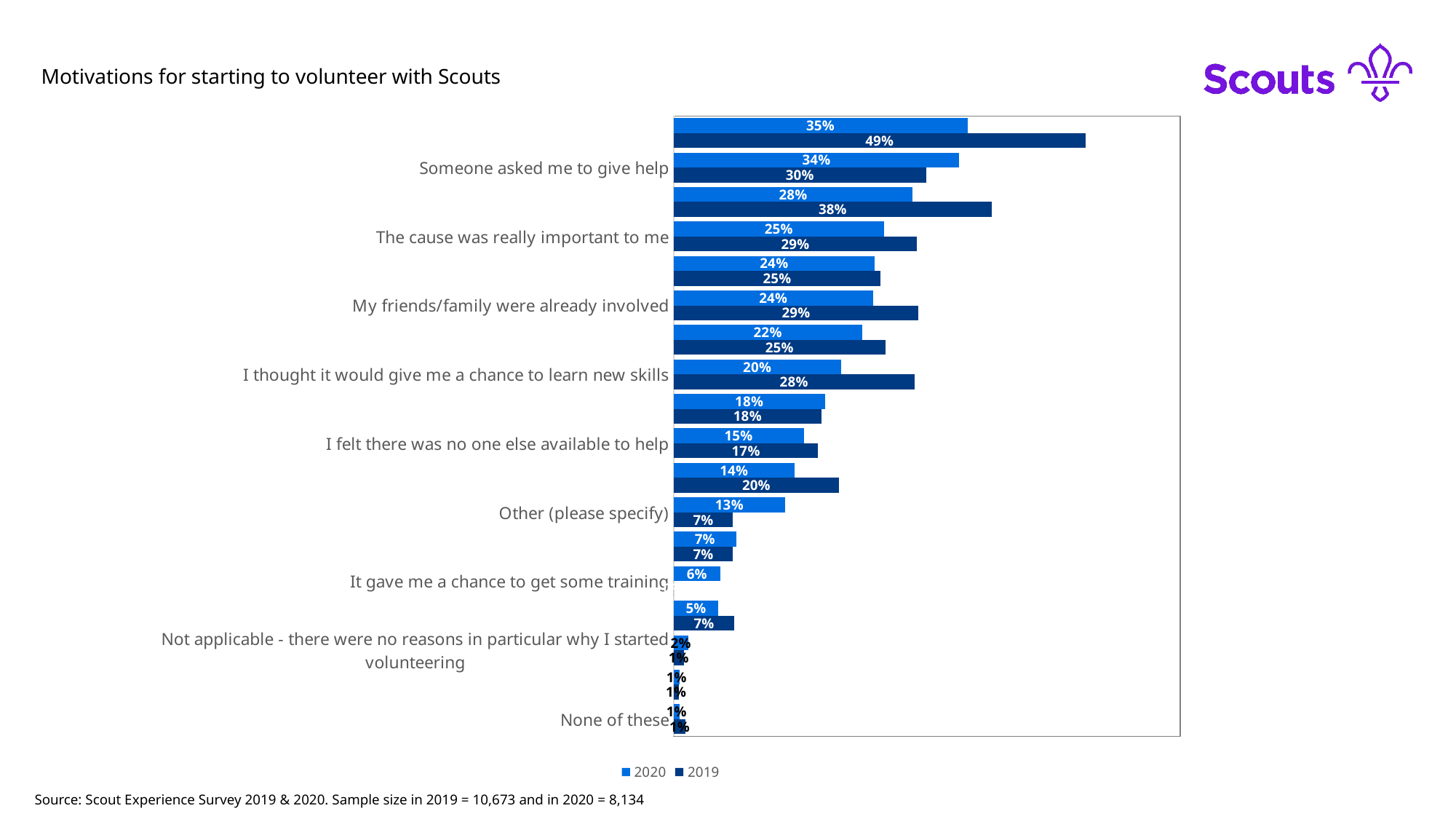
What is the title of the chart? Motivations for starting to volunteer with Scouts For 'The cause was really important to me', which year has the larger value, 2020 or 2019? 2019 What is the difference between the 2020 and 2019 values for 'Other (please specify)'? 6 percentage points What is the 2020 value for 'My friends/family were already involved'? 24% What is the 2020 value for 'Someone asked me to give help'? 34% What kind of chart is shown on the slide? bar chart What is the 2020 value for 'Other (please specify)'? 13% For 'Someone asked me to give help', which year has the larger value, 2020 or 2019? 2020 What is the 2019 value for 'The cause was really important to me'? 29% What is the 2019 value for 'I thought it would give me a chance to learn new skills'? 28% What is the 2019 value for 'Someone asked me to give help'? 30% How many series does the legend list? 2